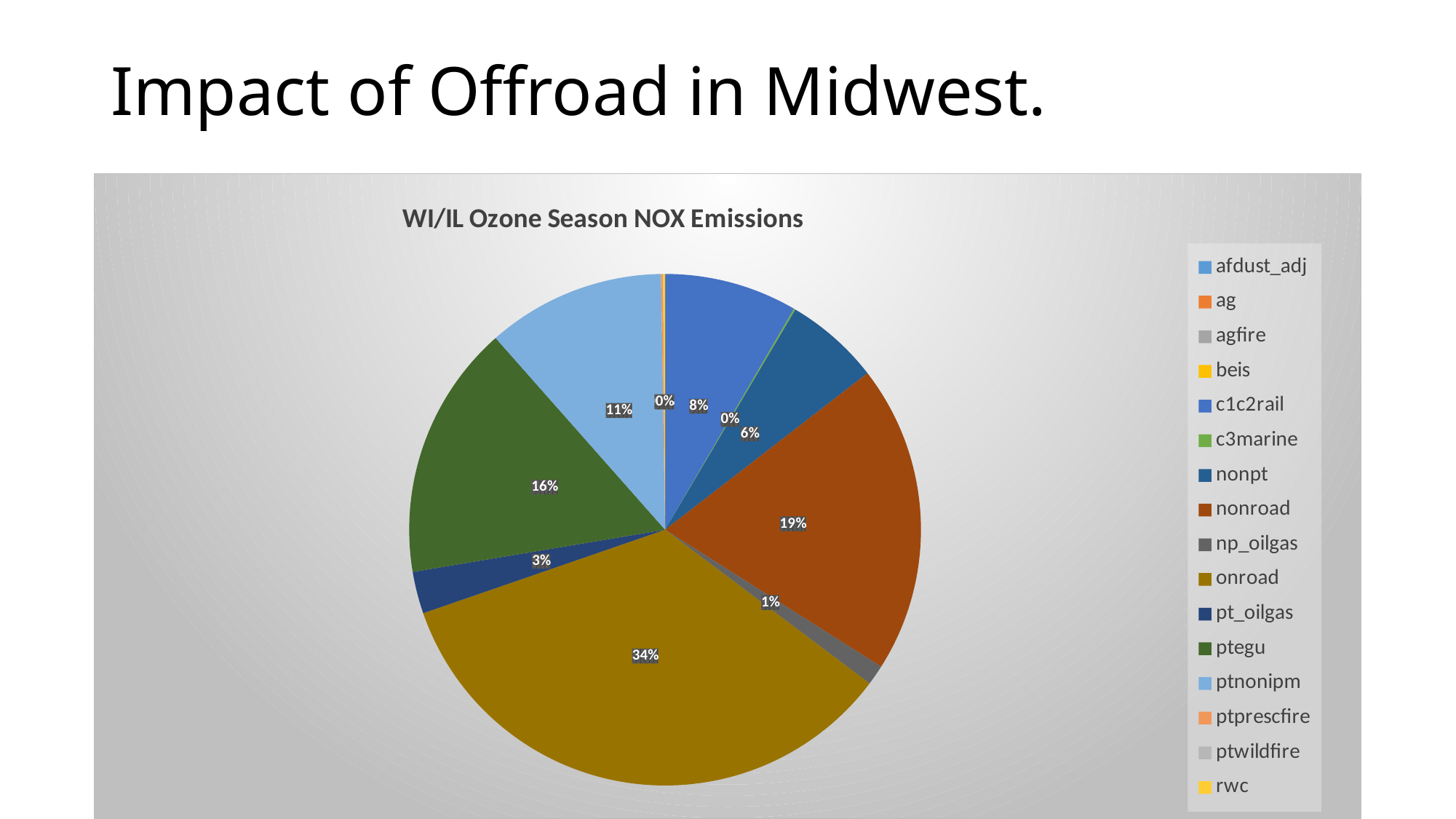
What is the title of the chart? WI/IL Ozone Season NOX Emissions How many entries does the legend list? 16 What percentage is shown for nonpt? 6% How many percentage points larger is the onroad share than the nonroad share? 15 What share of the pie does onroad account for? 34% What percentage is shown for c1c2rail? 8% Which category has the largest share of the pie? onroad What percentage is shown for ptnonipm? 11% Which is larger, the share for nonroad or the share for ptegu? nonroad What kind of chart is shown on the slide? pie chart What percentage is shown for ptegu? 16% What percentage is shown for nonroad? 19%